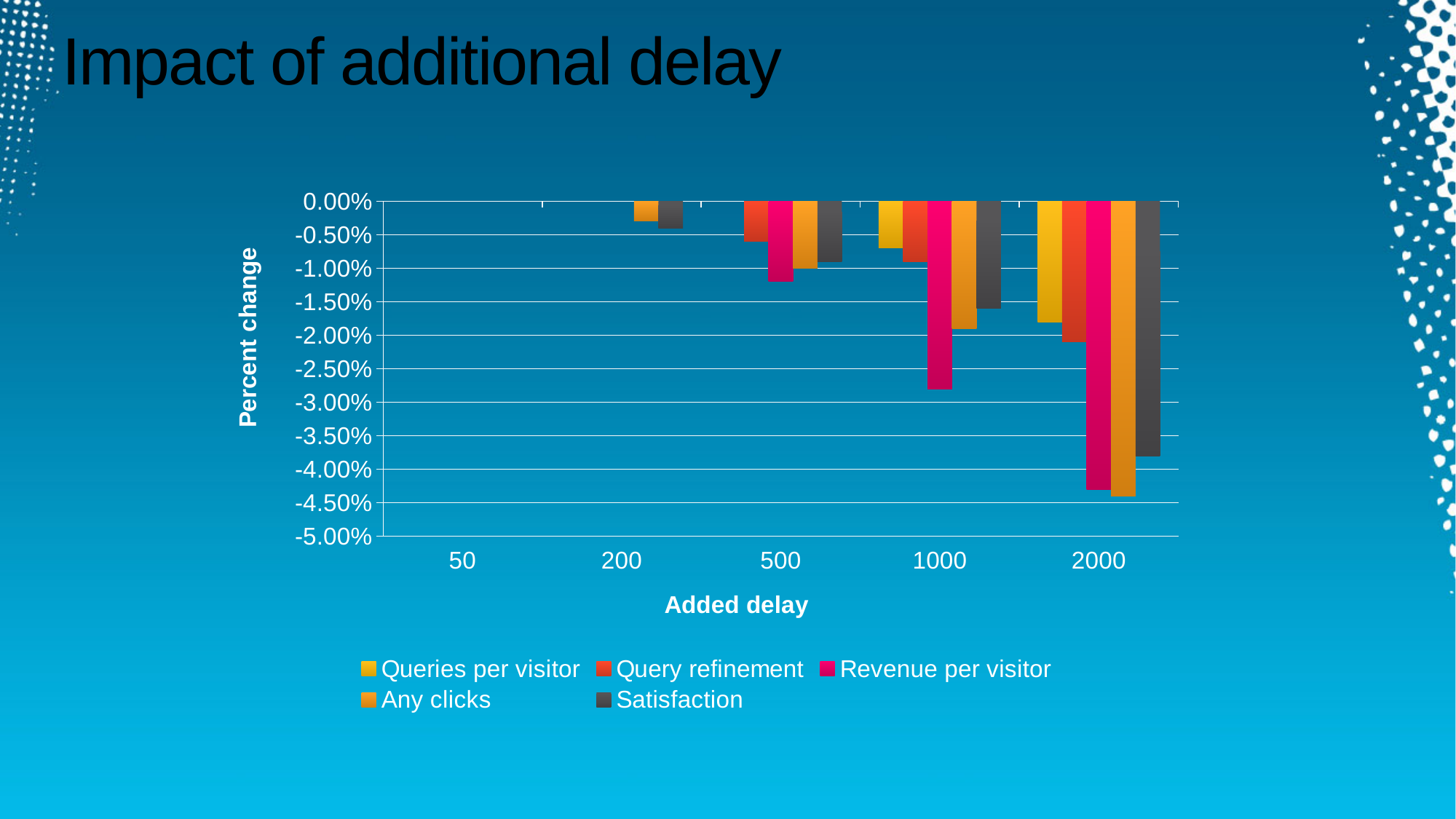
At which added delay does Satisfaction show its largest decrease? 2000 Is the value for Revenue per visitor at an added delay of 1000 greater or less than -2.50%? less How many added-delay categories are shown on the x axis? 5 At an added delay of 1000, which series shows the larger decrease: Revenue per visitor or Satisfaction? Revenue per visitor What is the label of the y axis? Percent change As the added delay increases along the x axis, do the percent-change values rise or fall? fall What is the title of the slide's chart? Impact of additional delay Is the value for Query refinement at an added delay of 500 greater or less than -1.00%? greater What kind of chart is shown on the slide? Bar chart How many series does the legend list? 5 Is the value for Satisfaction at an added delay of 2000 greater or less than -3.50%? less